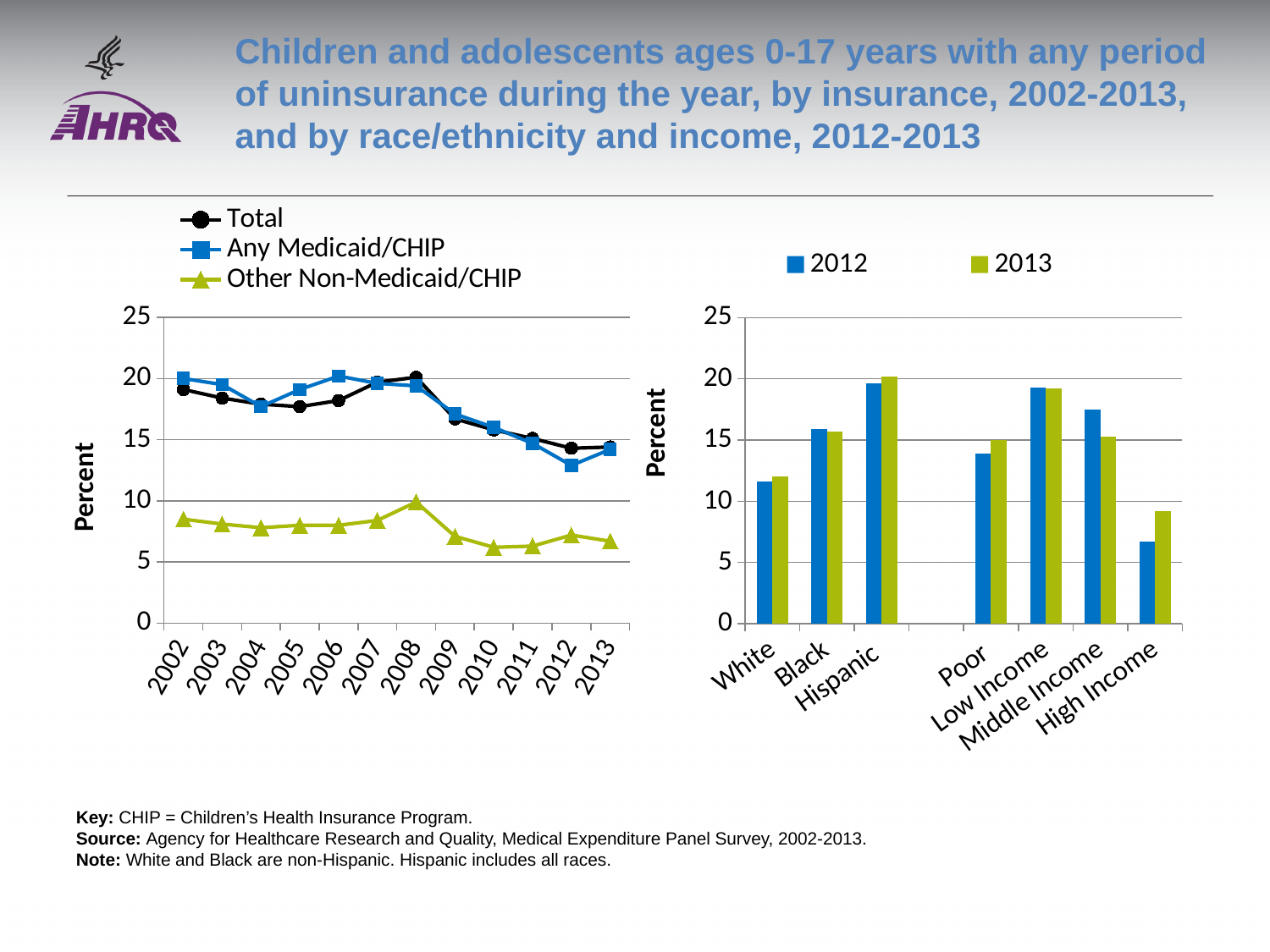
In the right chart, which category has the highest value in 2013? Hispanic In the right chart, is the value for High Income in 2013 greater or less than 10? less In the right chart, how many categories are shown on the x axis? 7 In the right chart, is the 2012 value for Middle Income larger or the 2013 value? 2012 In the left chart, is the value for Total in 2002 greater or less than 15? greater In the left chart, how many series does the legend list? 3 In the left chart, does the Total series rise or fall overall from 2002 to 2013? fall What kind of chart is the left chart on the slide? line chart In the left chart, which series has the lowest values across all years? Other Non-Medicaid/CHIP In the right chart, which category has the lowest value in 2012? High Income What kind of chart is the right chart on the slide? bar chart In the left chart, is the value for Other Non-Medicaid/CHIP in 2010 greater or less than 10? less